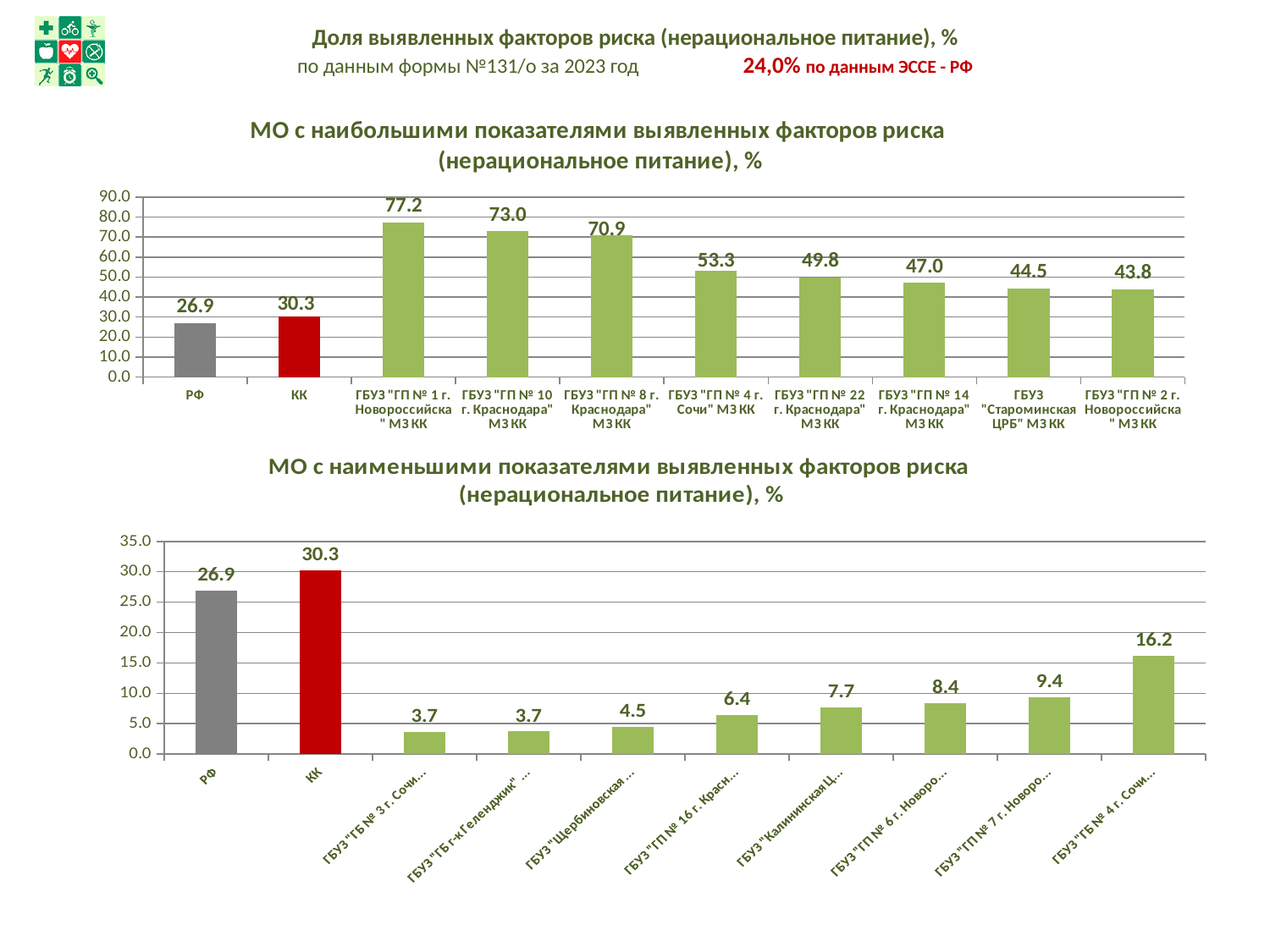
In the bottom chart (МО с наименьшими показателями), what is the value for ГБУЗ "ГБ № 4 г. Сочи..."? 16.2 What type of chart is the top chart (МО с наибольшими показателями)? Bar chart In the bottom chart (МО с наименьшими показателями), which of the two is larger: the value for ГБУЗ "ГП № 6 г. Новоро..." or ГБУЗ "ГП № 7 г. Новоро..."? ГБУЗ "ГП № 7 г. Новоро..." In the bottom chart (МО с наименьшими показателями), what is the value for КК? 30.3 In the top chart (МО с наибольшими показателями), what is the value for ГБУЗ "Староминская ЦРБ" МЗ КК? 44.5 In the top chart (МО с наибольшими показателями), which category has the highest value? ГБУЗ "ГП № 1 г. Новороссийска" МЗ КК In the top chart (МО с наибольшими показателями), how many bars are plotted? 10 In the bottom chart (МО с наименьшими показателями), what is the difference between the values for РФ and ГБУЗ "Щербиновская..."? 22.4 In the top chart (МО с наибольшими показателями), what is the difference between the values for ГБУЗ "ГП № 10 г. Краснодара" МЗ КК and ГБУЗ "ГП № 8 г. Краснодара" МЗ КК? 2.1 In the top chart (МО с наибольшими показателями), which category has the lowest value? РФ In the bottom chart (МО с наименьшими показателями), is the value for ГБУЗ "Калининская Ц..." greater or less than 10.0? less In the top chart (МО с наибольшими показателями), what is the value for ГБУЗ "ГП № 1 г. Новороссийска" МЗ КК? 77.2